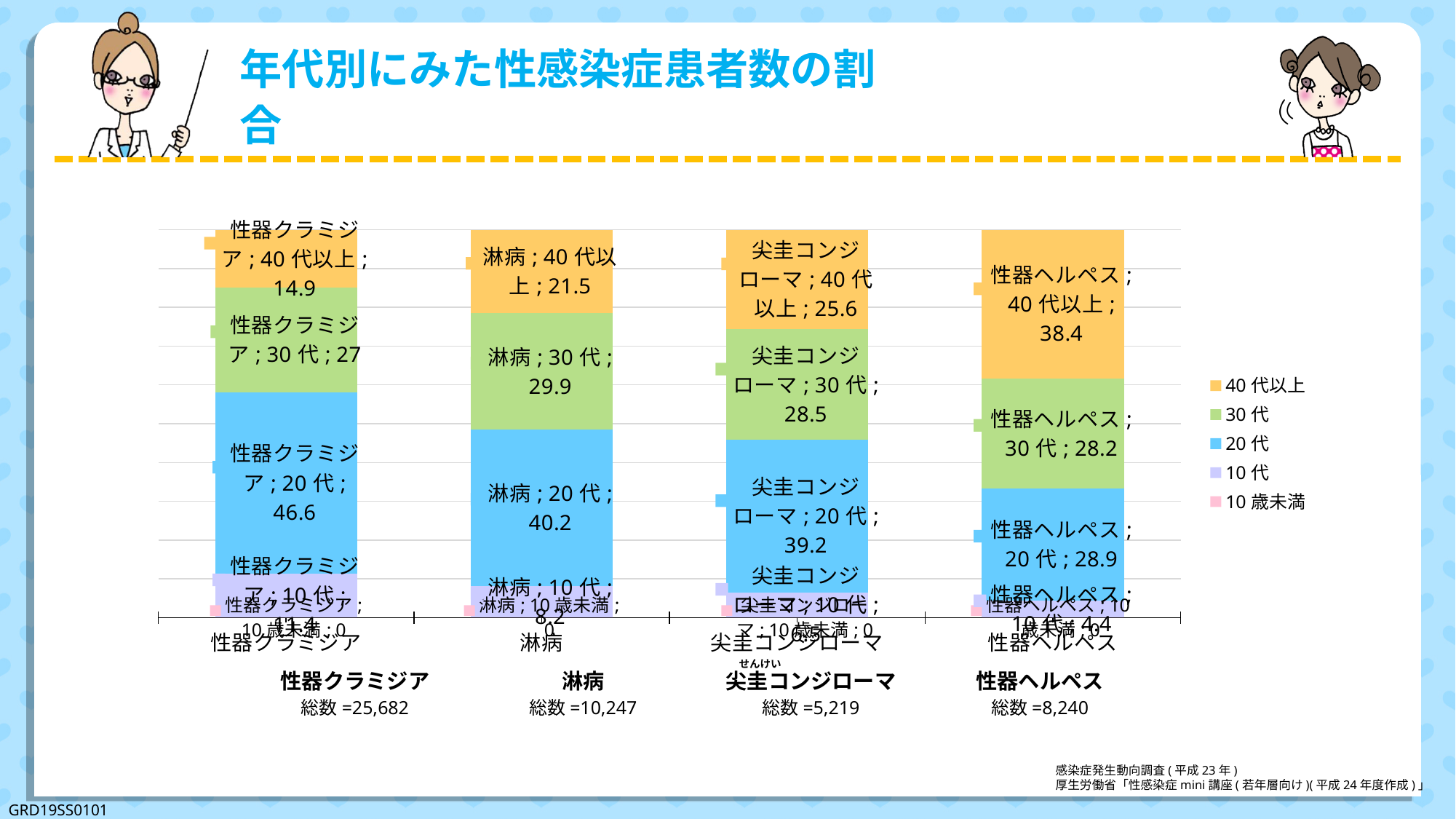
How many disease categories are plotted along the x axis? 4 How many series does the legend list? 5 Which disease has the highest value for the 20代 segment? 性器クラミジア Which is larger: the 20代 value for 淋病 or the 20代 value for 性器ヘルペス? 淋病 Which colour represents 30代 in the legend? Green Which disease has the lowest value for the 40代以上 segment? 性器クラミジア What is the difference between the 40代以上 values for 性器ヘルペス and 性器クラミジア? 23.5 What is the value for 20代 in the 性器クラミジア bar? 46.6 What is the value for 40代以上 in the 尖圭コンジローマ bar? 25.6 What kind of chart is shown on the slide? Stacked bar chart What is the value for 30代 in the 淋病 bar? 29.9 What is the value for 40代以上 in the 性器ヘルペス bar? 38.4